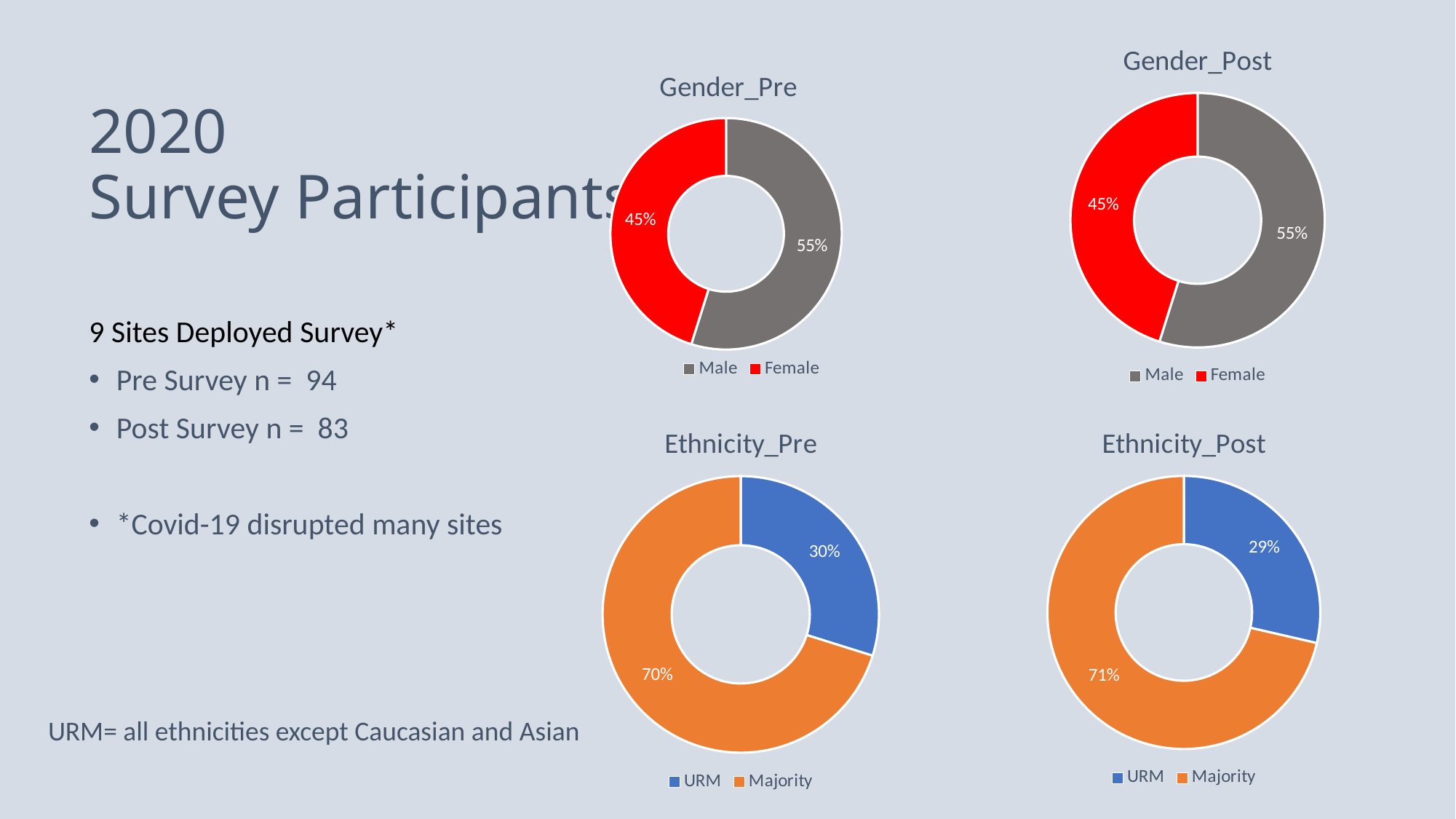
In the Ethnicity_Pre chart, what percentage is URM? 30% In the Gender_Pre chart, is the Male share larger or smaller than the Female share? larger What type of chart is the Ethnicity_Post chart? Doughnut chart In the Ethnicity_Pre chart, which category has the largest share? Majority In the Ethnicity_Post chart, what percentage is URM? 29% In the Gender_Post chart, which category has the smallest share? Female In the Ethnicity_Post chart, what percentage is Majority? 71% In the Gender_Pre chart, what percentage is Male? 55% How many categories does the legend of the Gender_Pre chart list? 2 In the Gender_Pre chart, what percentage is Female? 45% In the Ethnicity_Pre chart, what is the difference between the Majority and URM shares? 40% In the Gender_Post chart, what percentage is Female? 45%